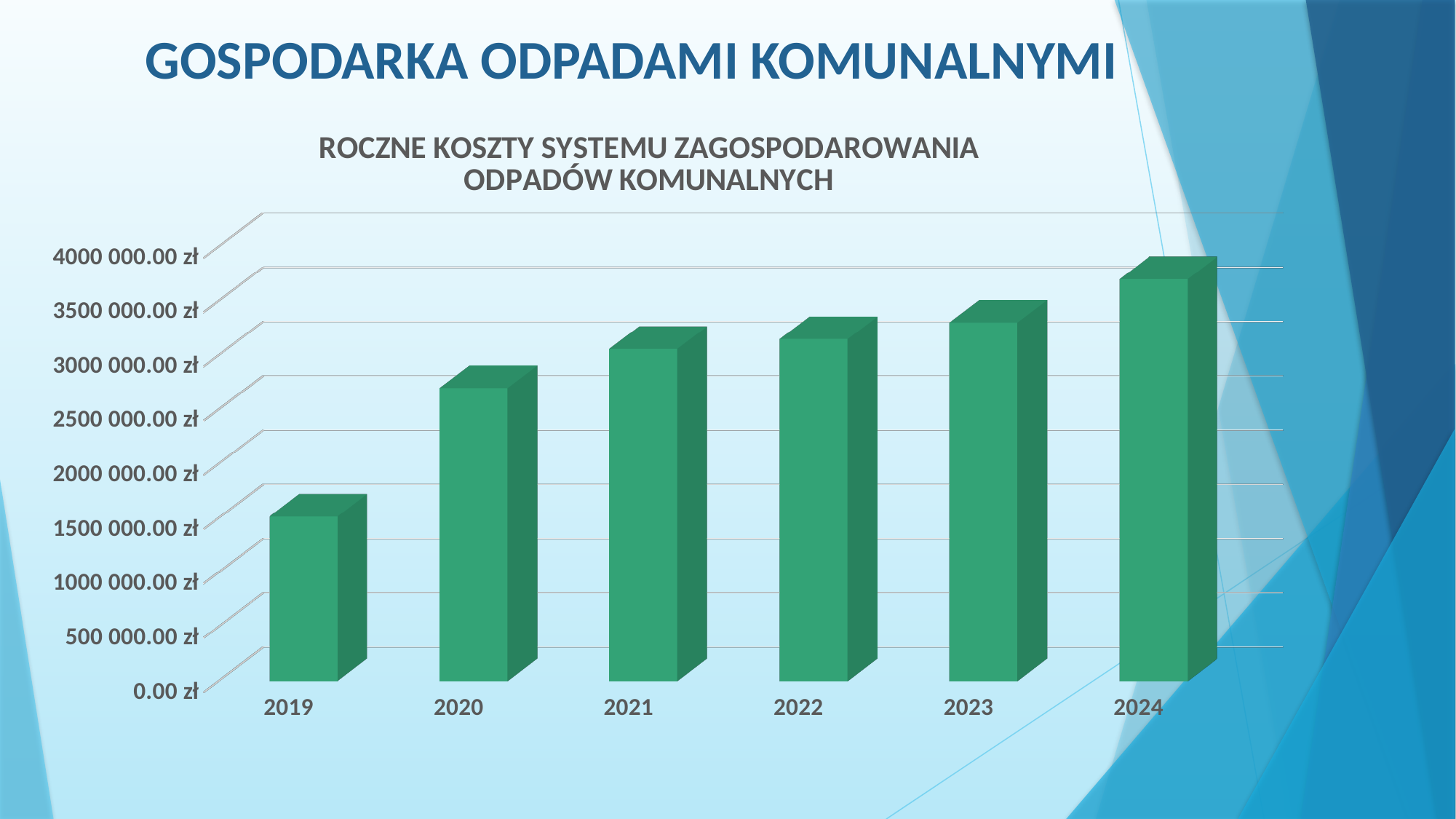
How many years are shown on the x axis of the chart? 6 Is the value for 2020 greater or less than 2500 000.00 zł? greater Which year has the highest annual cost in the chart? 2024 Is the value for 2019 greater or less than 2000 000.00 zł? less Which year has the larger value, 2019 or 2020? 2020 Is the value for 2022 greater or less than 3000 000.00 zł? greater Do the annual costs rise or fall from 2019 to 2024? rise What colour are the bars in the chart? green Which year has the lowest annual cost in the chart? 2019 What is the title of the chart? ROCZNE KOSZTY SYSTEMU ZAGOSPODAROWANIA ODPADÓW KOMUNALNYCH What kind of chart is shown on the slide? bar chart